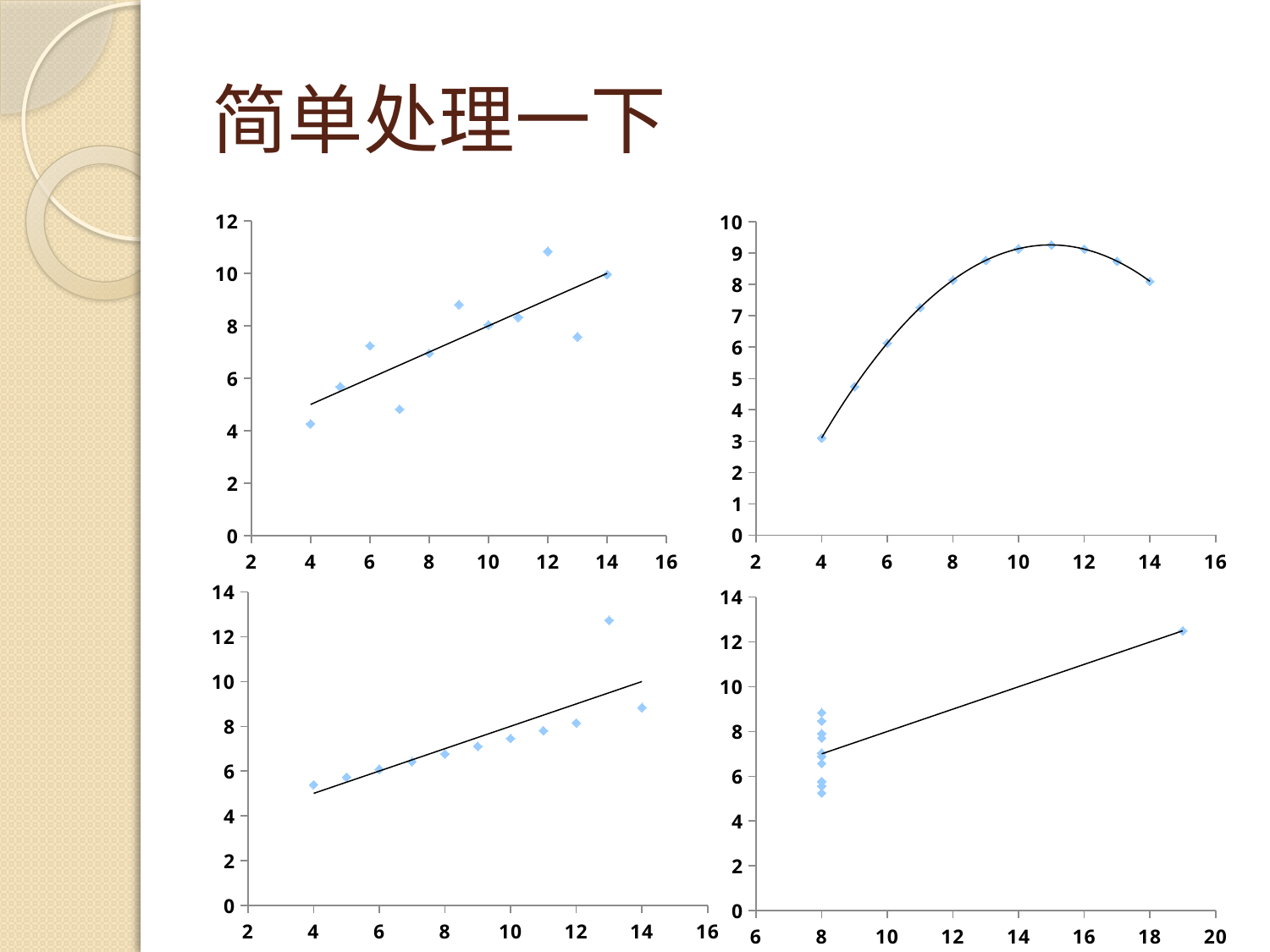
In the top-left chart, at which x value is the highest point? 12 What kind of chart is the top-left chart? scatter chart In the top-right chart, is the value of the point at x = 4 greater or less than 4? less In the top-left chart, do the points generally rise or fall as x increases? rise In the bottom-left chart, is the value of the point at x = 13 greater or less than 12? greater In the top-left chart, is the value of the point at x = 12 greater or less than 10? greater In the top-right chart, what is the maximum value shown on the y axis? 10 How many charts are shown on the slide? 4 In the top-right chart, at which x value is the lowest point? 4 In the bottom-left chart, at which x value is the highest point? 13 In the top-left chart, how many data points are plotted? 11